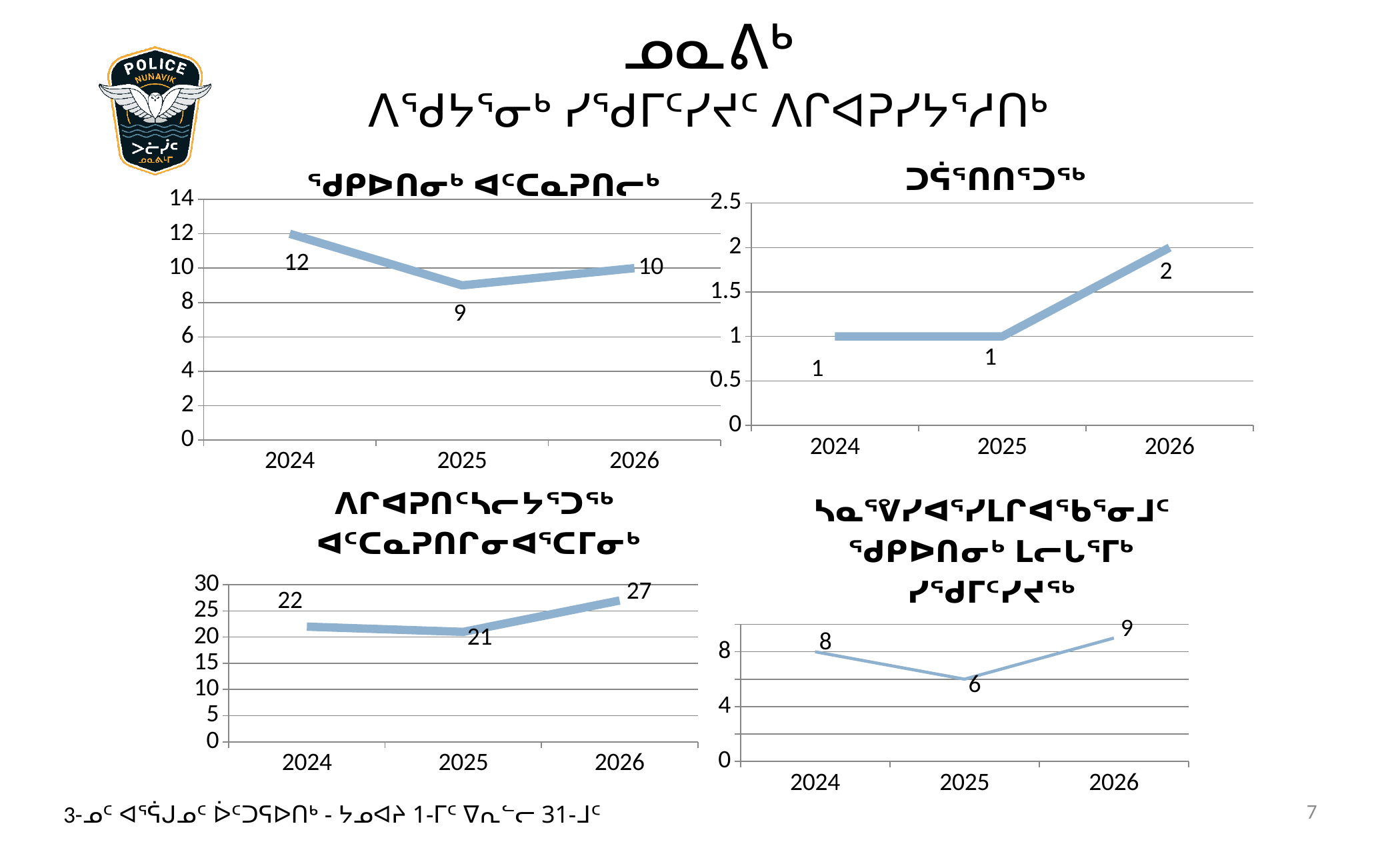
In the bottom-left chart, what is the difference between the 2026 and 2025 values? 6 How many data points are plotted in the bottom-right chart? 3 In the bottom-right chart, which year has the highest value? 2026 In the bottom-left chart, what is the value for 2026? 27 In the bottom-left chart, is the value for 2024 larger than the value for 2025? Yes In the bottom-right chart, what is the value for 2025? 6 In the top-right chart, which year has the highest value? 2026 In the top-left chart, what is the value for 2024? 12 In the top-left chart, what is the difference between the 2024 and 2025 values? 3 What kind of chart is the top-right chart? Line chart In the top-right chart, what is the value for 2026? 2 In the top-left chart, which year has the lowest value? 2025